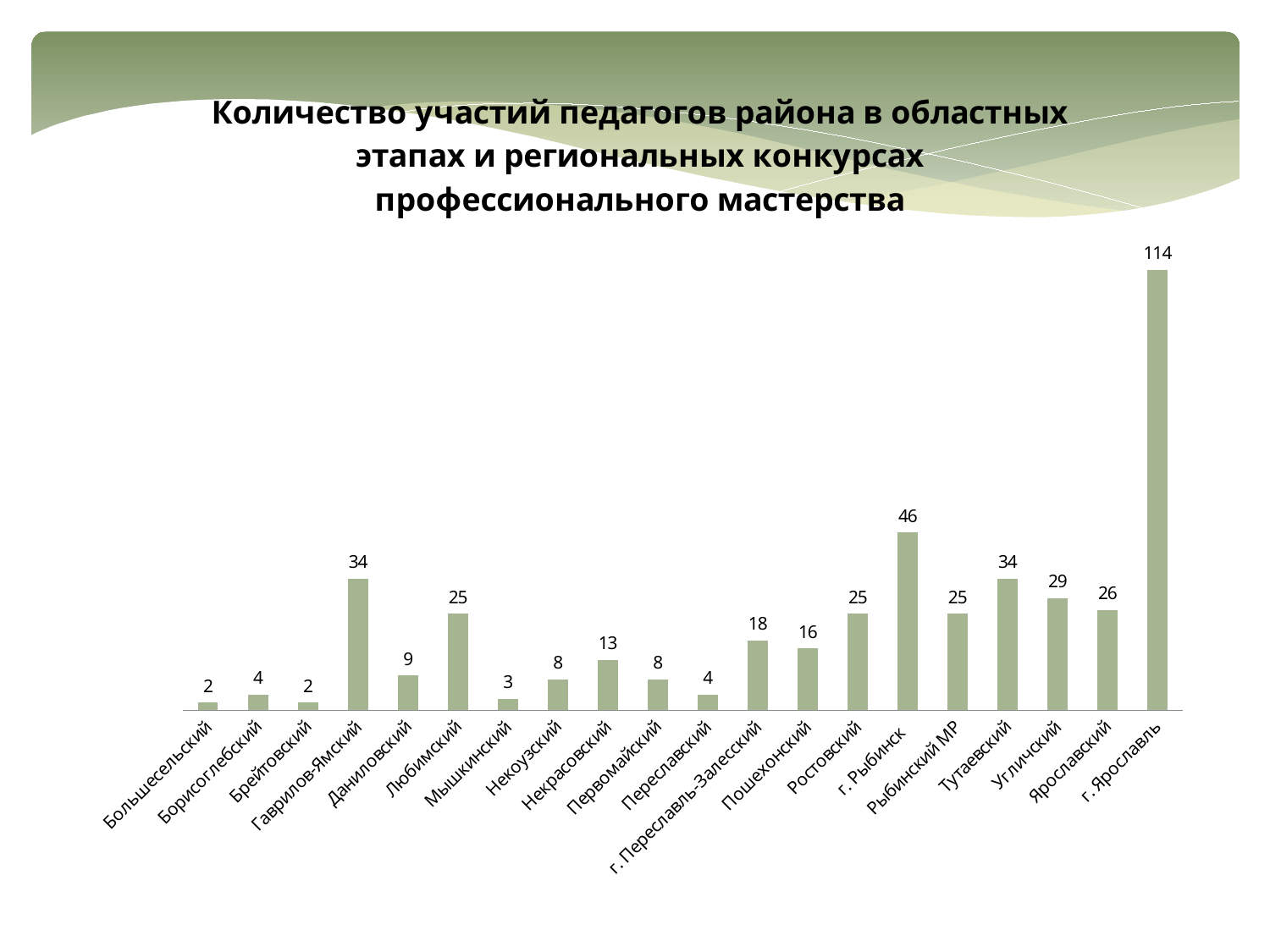
What is the value for Пошехонский? 16 Which category has the highest value? г. Ярославль What is the title of the chart? Количество участий педагогов района в областных этапах и региональных конкурсах профессионального мастерства What type of chart is shown on the slide? bar chart Which is larger, the value for Угличский or the value for Ярославский? Угличский What is the difference between the values for г. Ярославль and г. Рыбинск? 68 What is the value for Гаврилов-Ямский? 34 What is the difference between the values for Тутаевский and Некрасовский? 21 How many categories (districts) are shown on the chart? 20 What is the value for г. Рыбинск? 46 What is the value for Мышкинский? 3 What is the value for г. Ярославль? 114